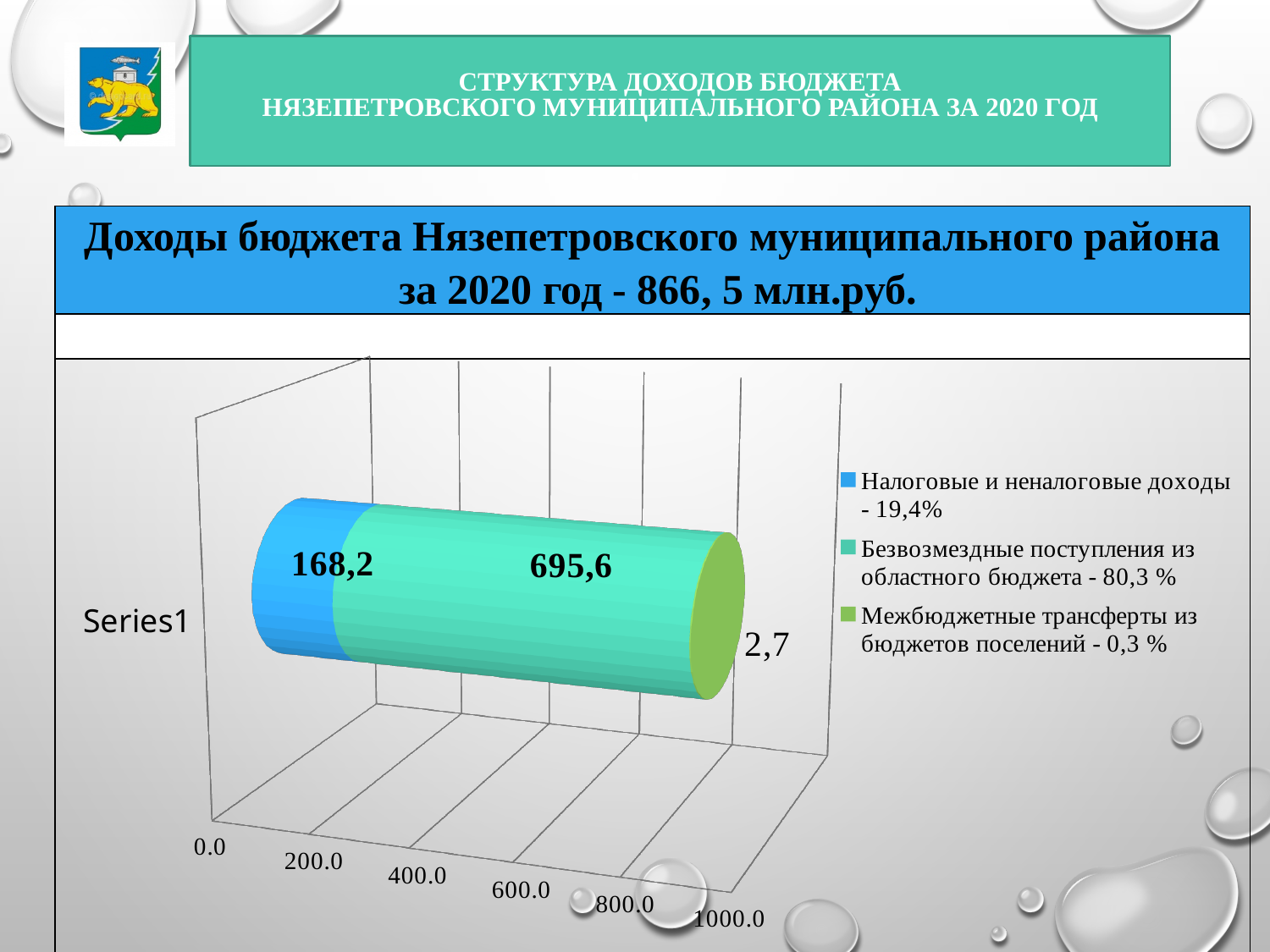
What is the total of the stacked bar? 866,5 What percentage share does the legend give for 'Безвозмездные поступления из областного бюджета'? 80,3 % What is the value of the 'Безвозмездные поступления из областного бюджета' segment of the bar? 695,6 What is the value of the 'Налоговые и неналоговые доходы' segment of the bar? 168,2 What is the difference between the 'Безвозмездные поступления из областного бюджета' value and the 'Налоговые и неналоговые доходы' value? 527,4 Which series has the largest value in the bar? Безвозмездные поступления из областного бюджета What kind of chart is shown on the slide? Stacked bar chart Which series has the smallest value in the bar? Межбюджетные трансферты из бюджетов поселений Which is larger: the 'Налоговые и неналоговые доходы' value or the 'Межбюджетные трансферты из бюджетов поселений' value? Налоговые и неналоговые доходы What is the highest value shown on the horizontal axis? 1000.0 What is the value of the 'Межбюджетные трансферты из бюджетов поселений' segment of the bar? 2,7 How many series does the legend list? 3